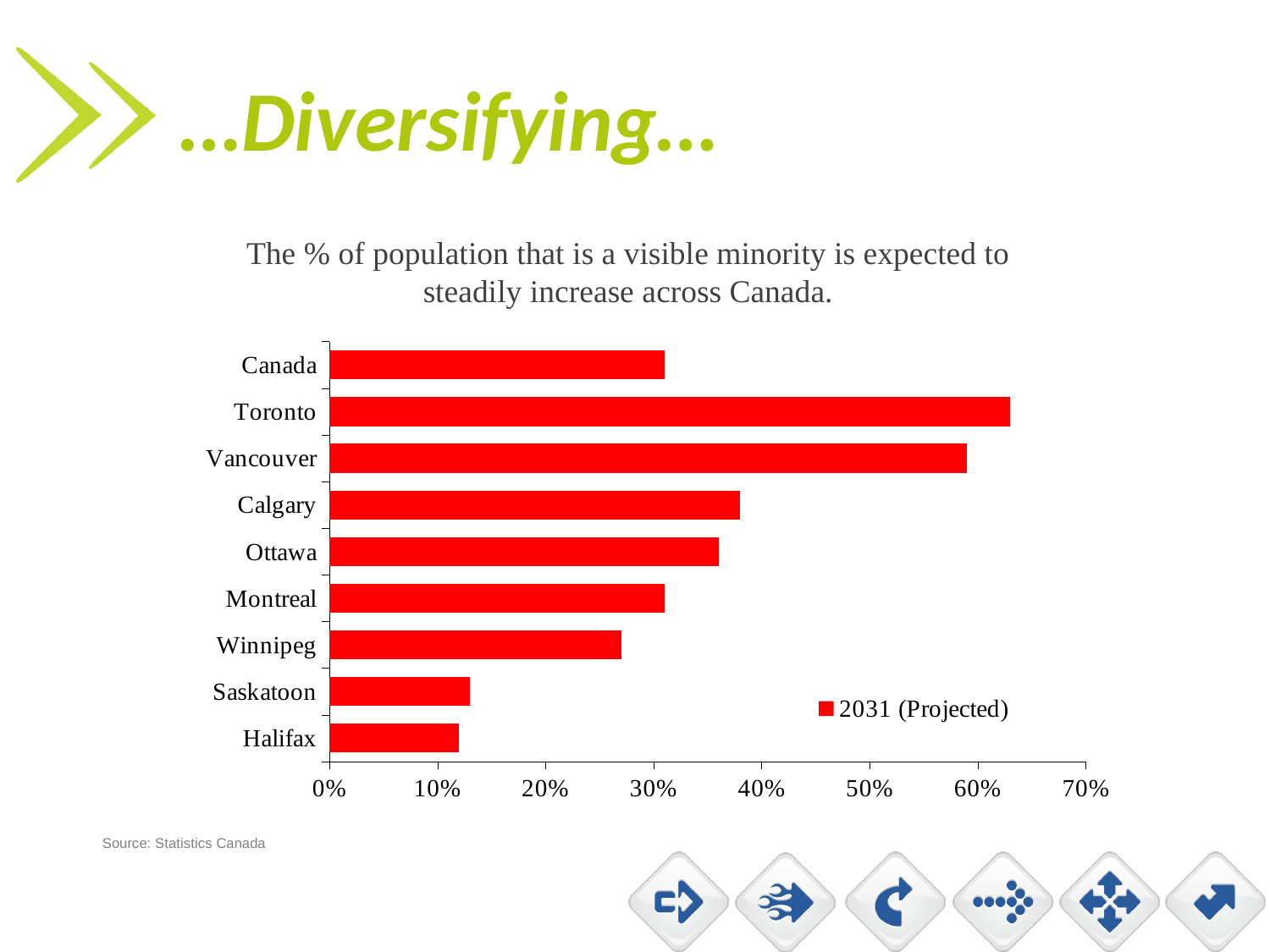
Is the value for Toronto greater or less than 60%? greater Which has a larger value, Calgary or Canada? Calgary Which has a larger value, Toronto or Vancouver? Toronto How many series does the legend list? 1 What is the legend entry for the series shown on the chart? 2031 (Projected) Is the value for Winnipeg greater or less than 30%? less What kind of chart is shown on the slide? bar chart How many cities or regions are listed on the chart? 9 Which category has the highest projected visible minority percentage? Toronto Is the value for Saskatoon greater or less than 10%? greater